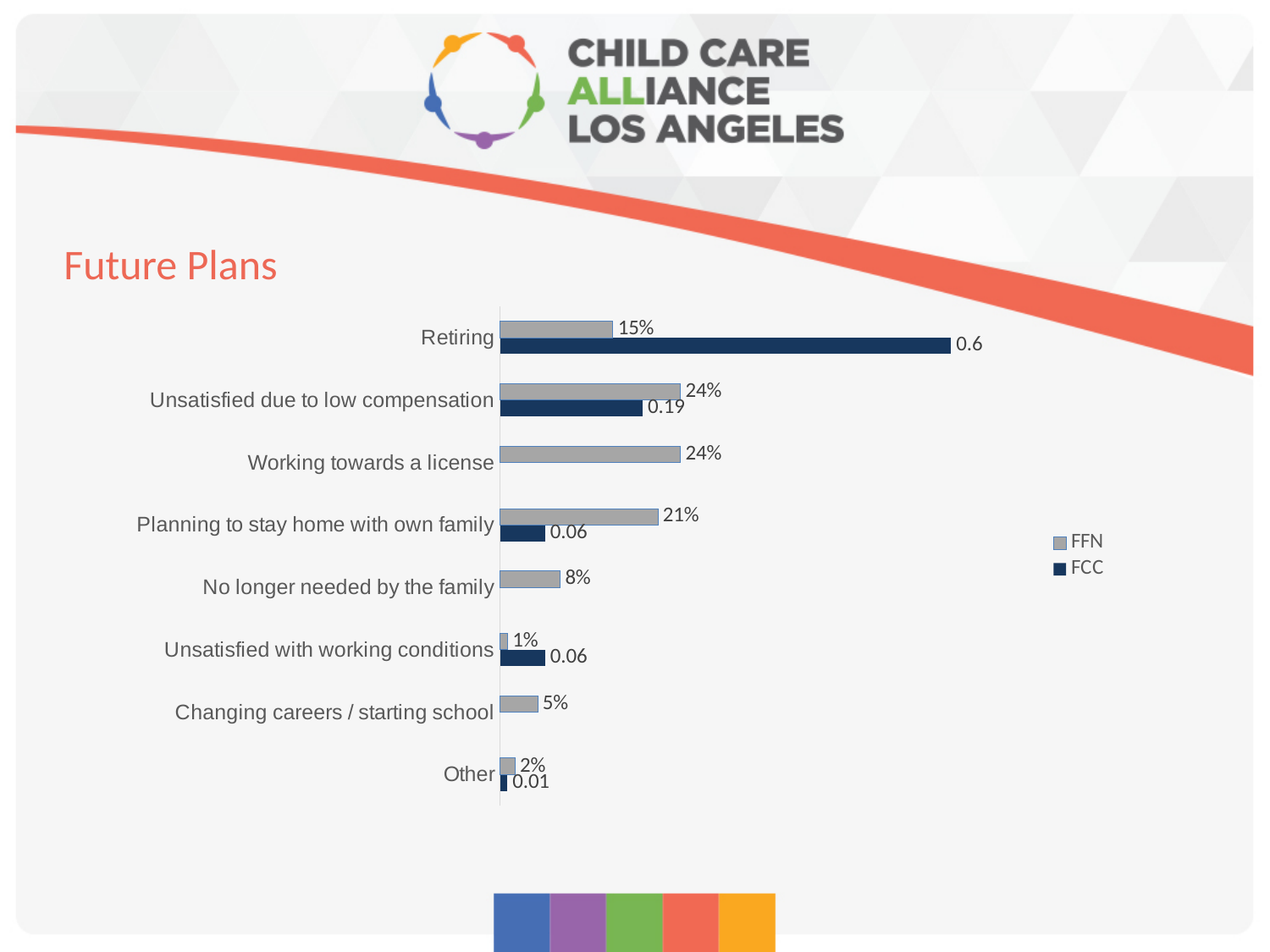
What is the FFN value for Retiring? 15% What is the difference between the FFN values for Retiring and Other? 13% How many categories are shown on the chart? 8 Which category has the lowest FFN value? Unsatisfied with working conditions What is the FCC value for Unsatisfied due to low compensation? 0.19 Which has a larger FFN value: Planning to stay home with own family or No longer needed by the family? Planning to stay home with own family What is the FFN value for Planning to stay home with own family? 21% How many series does the legend list? 2 What is the FFN value for Changing careers / starting school? 5% What is the FCC value for Retiring? 0.6 Which category has the highest FCC value? Retiring What kind of chart is shown on the slide? Bar chart